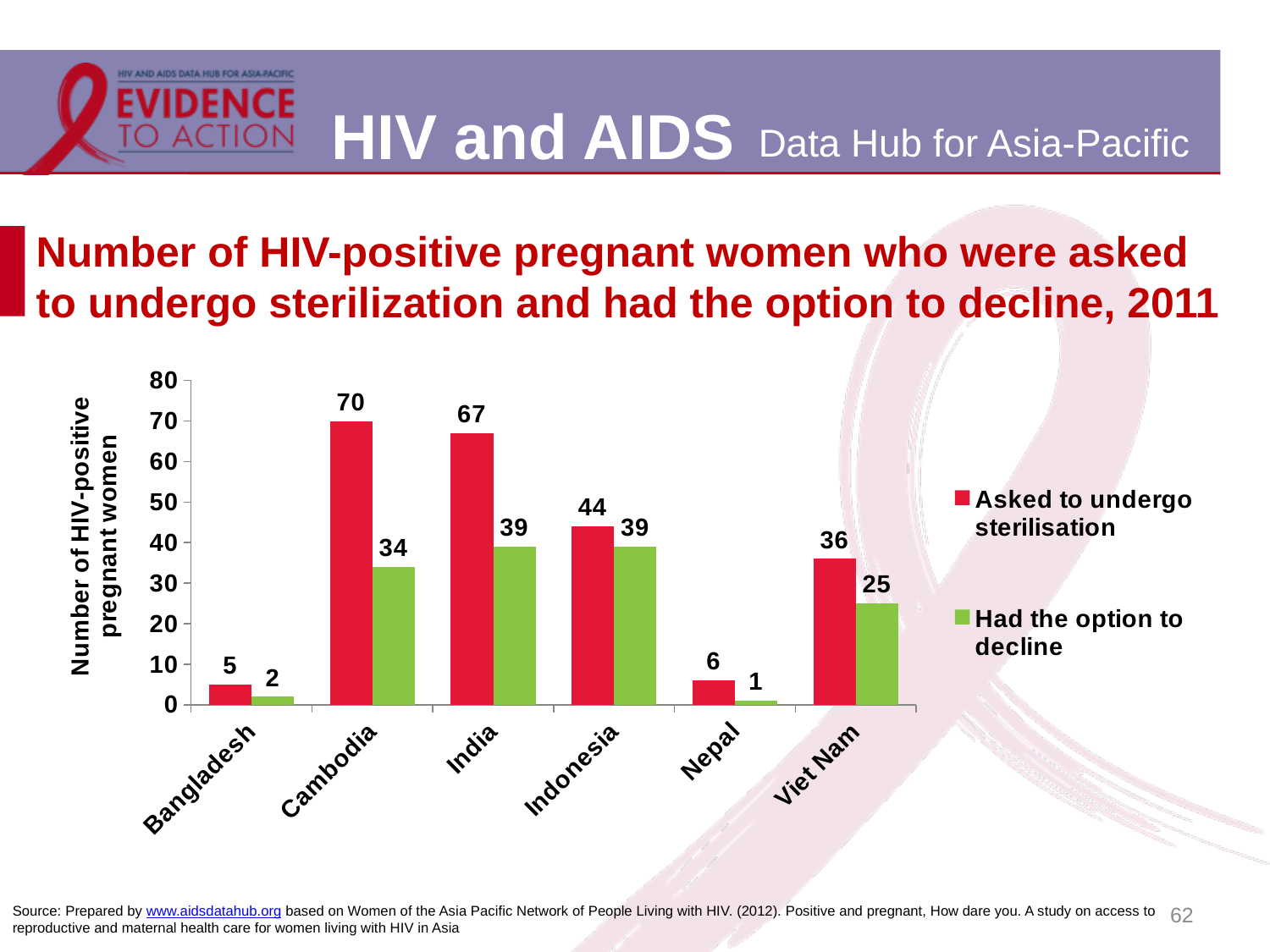
How many countries are shown on the x axis? 6 Which country has the lowest number of women who had the option to decline? Nepal What colour represents the 'Asked to undergo sterilisation' series? Red Which country has the highest number of women asked to undergo sterilisation? Cambodia What is the value for Bangladesh in the 'Had the option to decline' series? 2 What kind of chart is shown on the slide? Bar chart How many HIV-positive pregnant women in Cambodia were asked to undergo sterilisation? 70 What is the difference between the number asked to undergo sterilisation in Cambodia and in India? 3 Which is larger: the number asked to undergo sterilisation in Indonesia or in Viet Nam? Indonesia How many series does the legend list? 2 What is the difference between the number asked to undergo sterilisation and the number who had the option to decline in India? 28 How many HIV-positive pregnant women in Viet Nam had the option to decline? 25